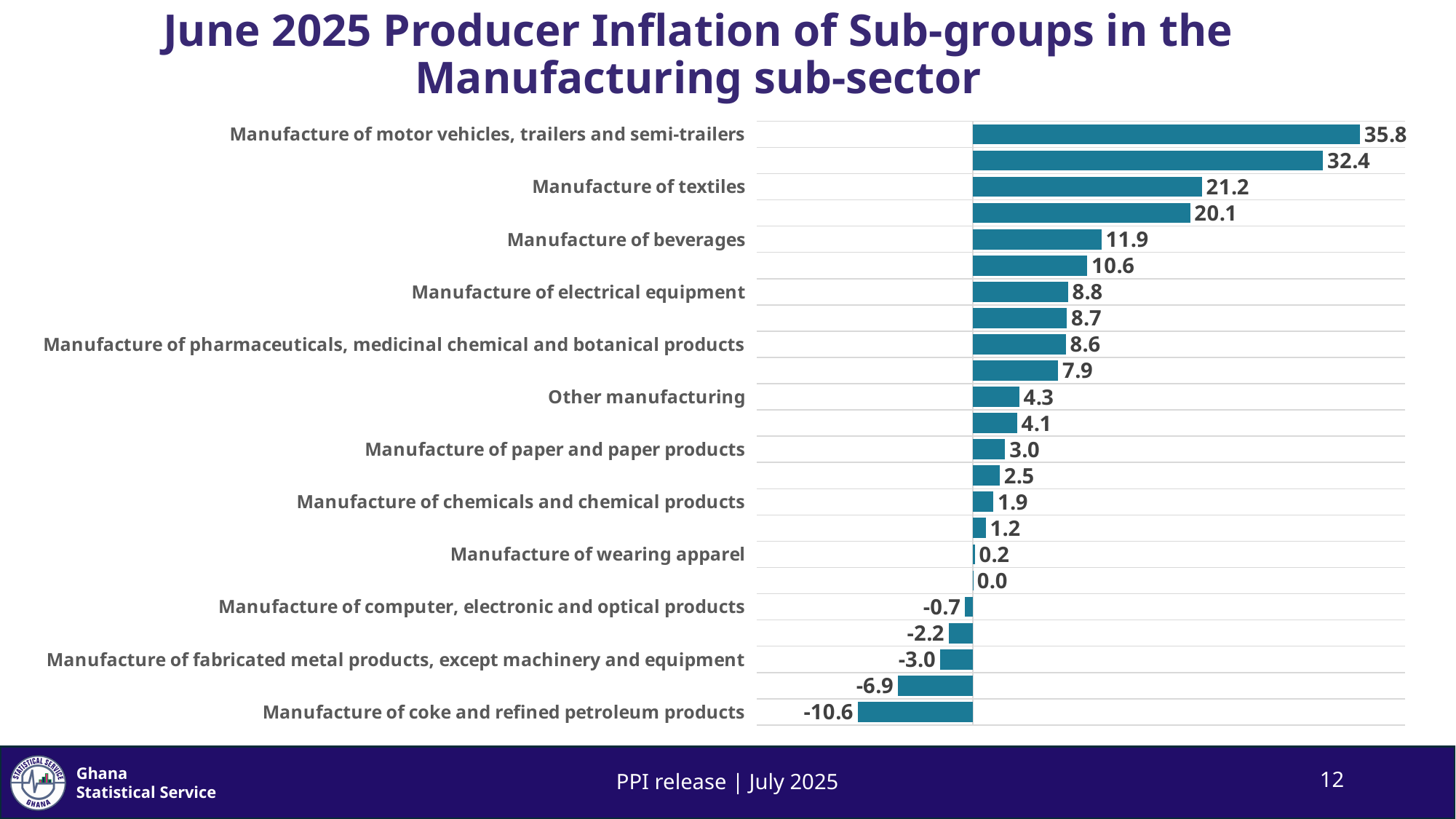
What type of chart is shown on the slide? Bar chart What is the value shown for Manufacture of pharmaceuticals, medicinal chemical and botanical products? 8.6 Which labelled sub-group has the lowest producer inflation? Manufacture of coke and refined petroleum products What is the difference between the values for Manufacture of textiles and Manufacture of beverages? 9.3 What is the difference between the values for Manufacture of motor vehicles, trailers and semi-trailers and Manufacture of textiles? 14.6 How many bars are plotted in the chart? 23 How many bars in the chart have negative values? 5 What is the value shown for Manufacture of coke and refined petroleum products? -10.6 What is the value shown for Manufacture of textiles? 21.2 Which is larger, the value for Manufacture of paper and paper products or Manufacture of chemicals and chemical products? Manufacture of paper and paper products Which labelled sub-group has the highest producer inflation? Manufacture of motor vehicles, trailers and semi-trailers What is the producer inflation value for Manufacture of motor vehicles, trailers and semi-trailers? 35.8